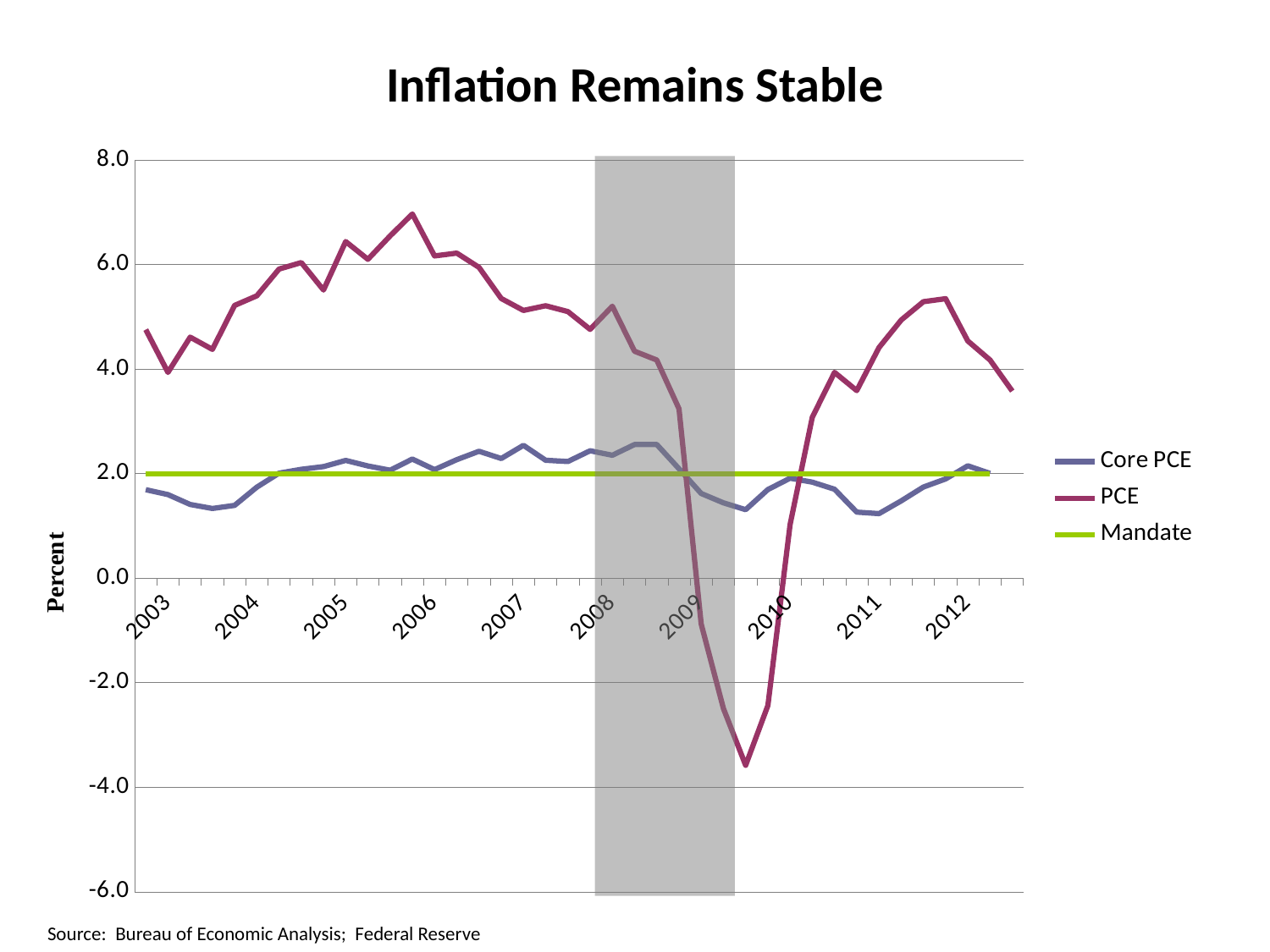
How many series does the legend list? 3 What is the title of the chart? Inflation Remains Stable Which series reaches the lowest value on the chart? PCE How many years are labelled on the x axis? 10 What kind of chart is shown on the slide? line chart Does the PCE line rise or fall between 2008 and 2009? fall Is the lowest value reached by PCE in 2009 greater or less than -2.0? less What value does the Mandate line sit at throughout the chart? 2.0 What is the label on the vertical axis? Percent Which series is larger at the start of 2006, PCE or Core PCE? PCE Is the value for PCE at the start of 2006 greater or less than 6.0? greater Is the value for Core PCE at the start of 2004 greater or less than 2.0? less